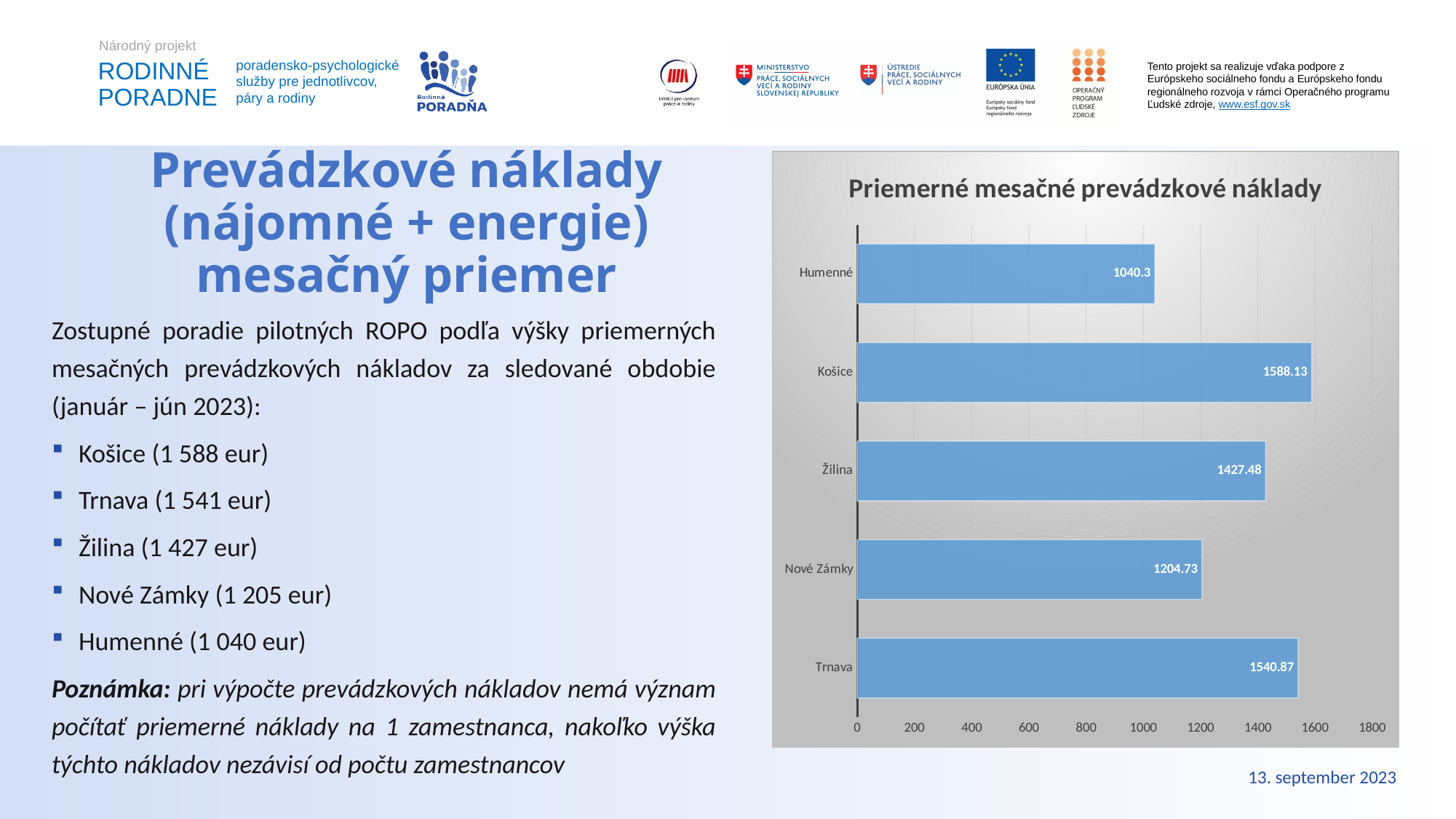
What is the difference between the values for Košice and Humenné? 547.83 What is the value for Trnava in the chart? 1540.87 Is the value for Humenné greater or less than 1200? less What type of chart is shown on the slide? bar chart Which is larger, the value for Žilina or the value for Nové Zámky? Žilina How many categories are shown in the chart? 5 What is the value for Košice in the chart? 1588.13 What is the value for Nové Zámky in the chart? 1204.73 What is the value for Humenné in the chart? 1040.3 What is the difference between the values for Žilina and Nové Zámky? 222.75 Which category has the lowest value in the chart? Humenné Which category has the highest value in the chart? Košice